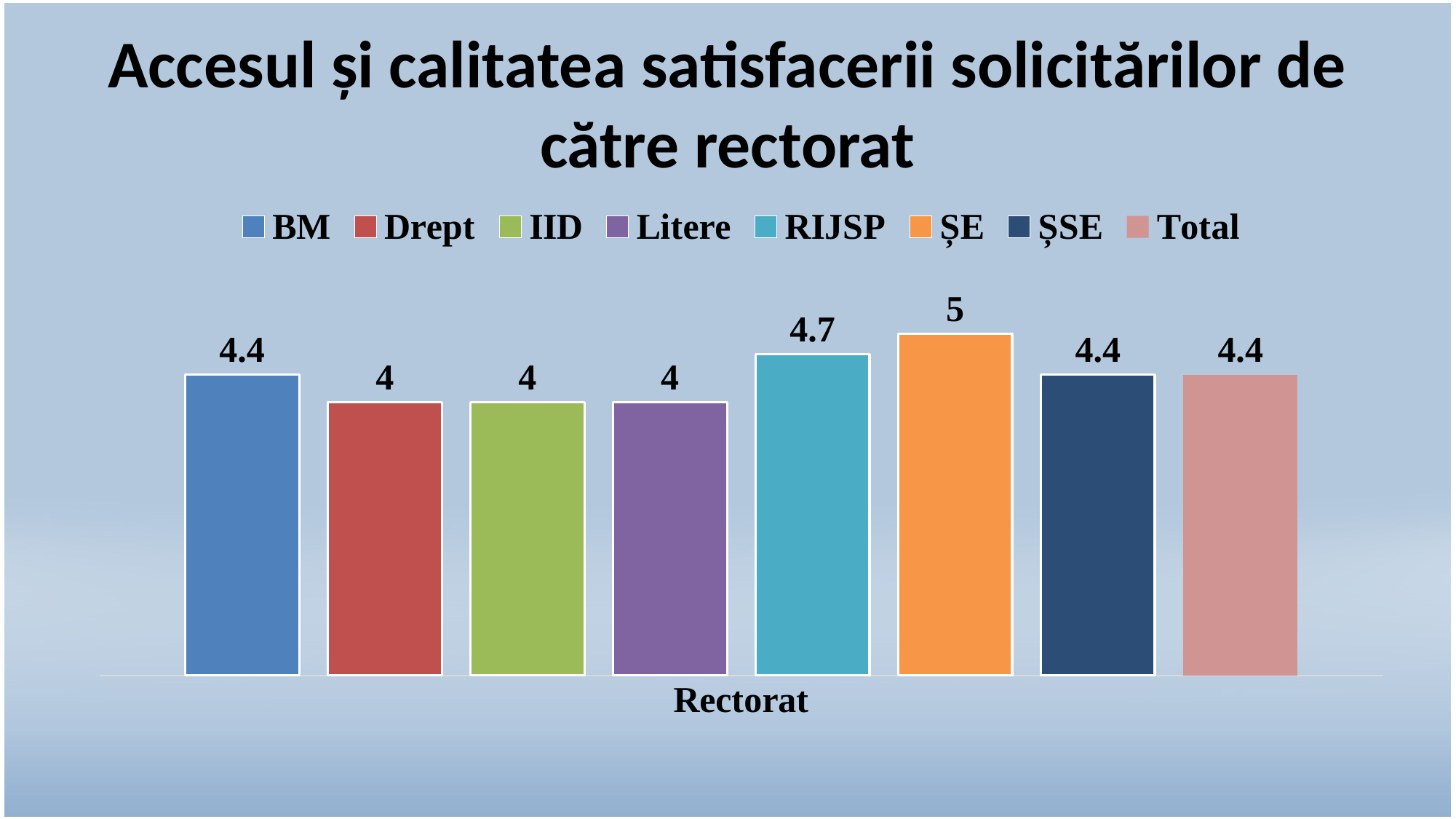
Which is larger, the value for RIJSP or the value for Litere? RIJSP What is the category label shown on the x axis? Rectorat What is the value for ȘE? 5 What is the title of the chart? Accesul și calitatea satisfacerii solicitărilor de către rectorat What is the difference between the values for ȘE and Drept? 1 Which series has the highest value? ȘE What is the value for RIJSP? 4.7 What kind of chart is shown on the slide? bar chart What is the value for BM? 4.4 How many series does the legend list? 8 What is the difference between the values for RIJSP and ȘSE? 0.3 What is the value for Total? 4.4